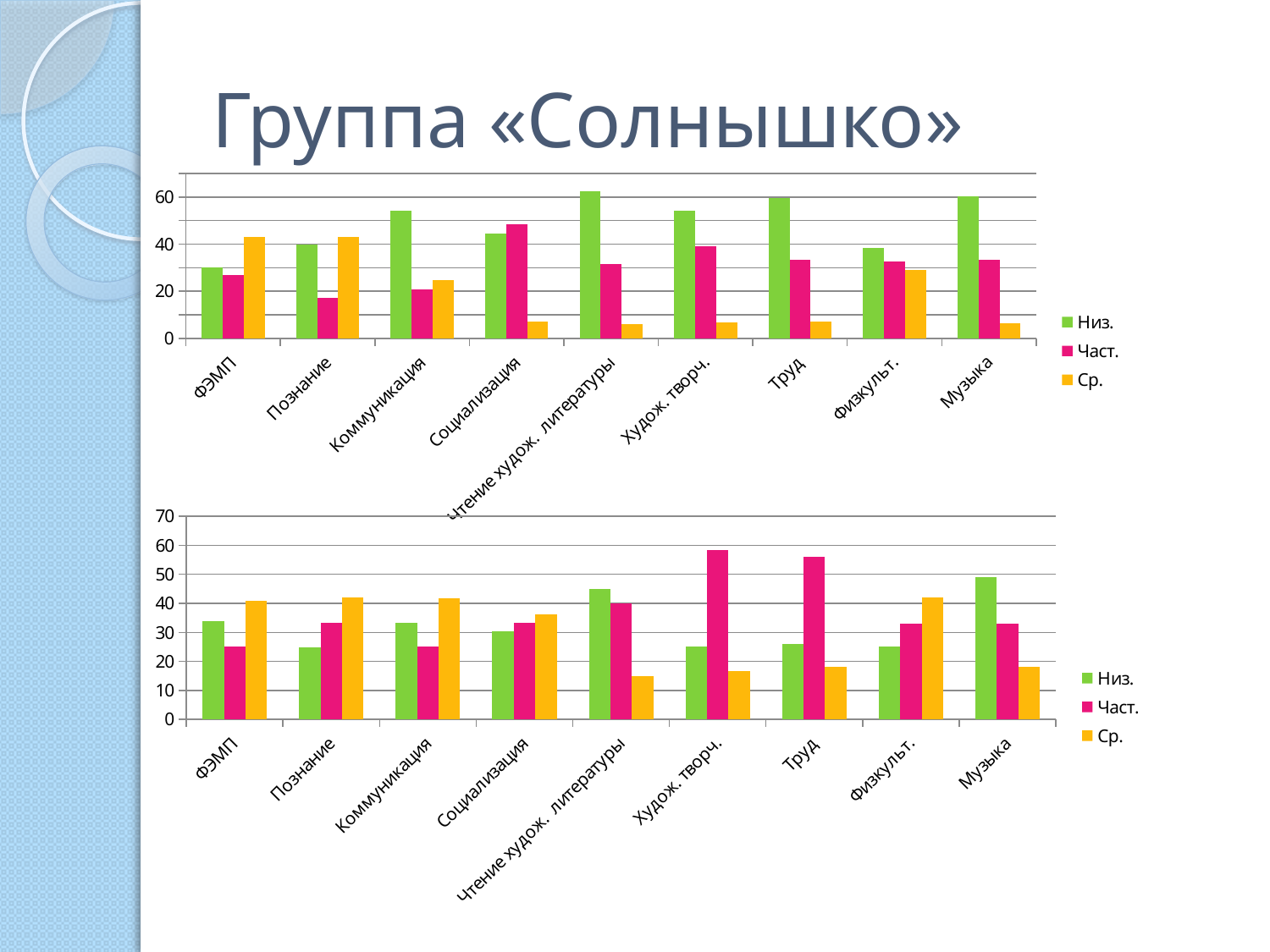
In the bottom chart, is the Ср. value for Чтение худож. литературы greater or less than 20? less In the top chart, which category has the lowest Низ. value? ФЭМП What kind of chart is the top chart on the slide? bar chart How many categories are shown on the x axis of the bottom chart? 9 In the bottom chart, for Труд, which is larger: the Низ. value or the Част. value? Част. In the bottom chart, is the Низ. value for Музыка greater or less than 40? greater In the top chart, is the Част. value for Социализация greater or less than 40? greater In the top chart, for ФЭМП, which is larger: the Низ. value or the Ср. value? Ср. How many series does the legend of the top chart list? 3 In the bottom chart, which category has the highest Низ. value? Музыка